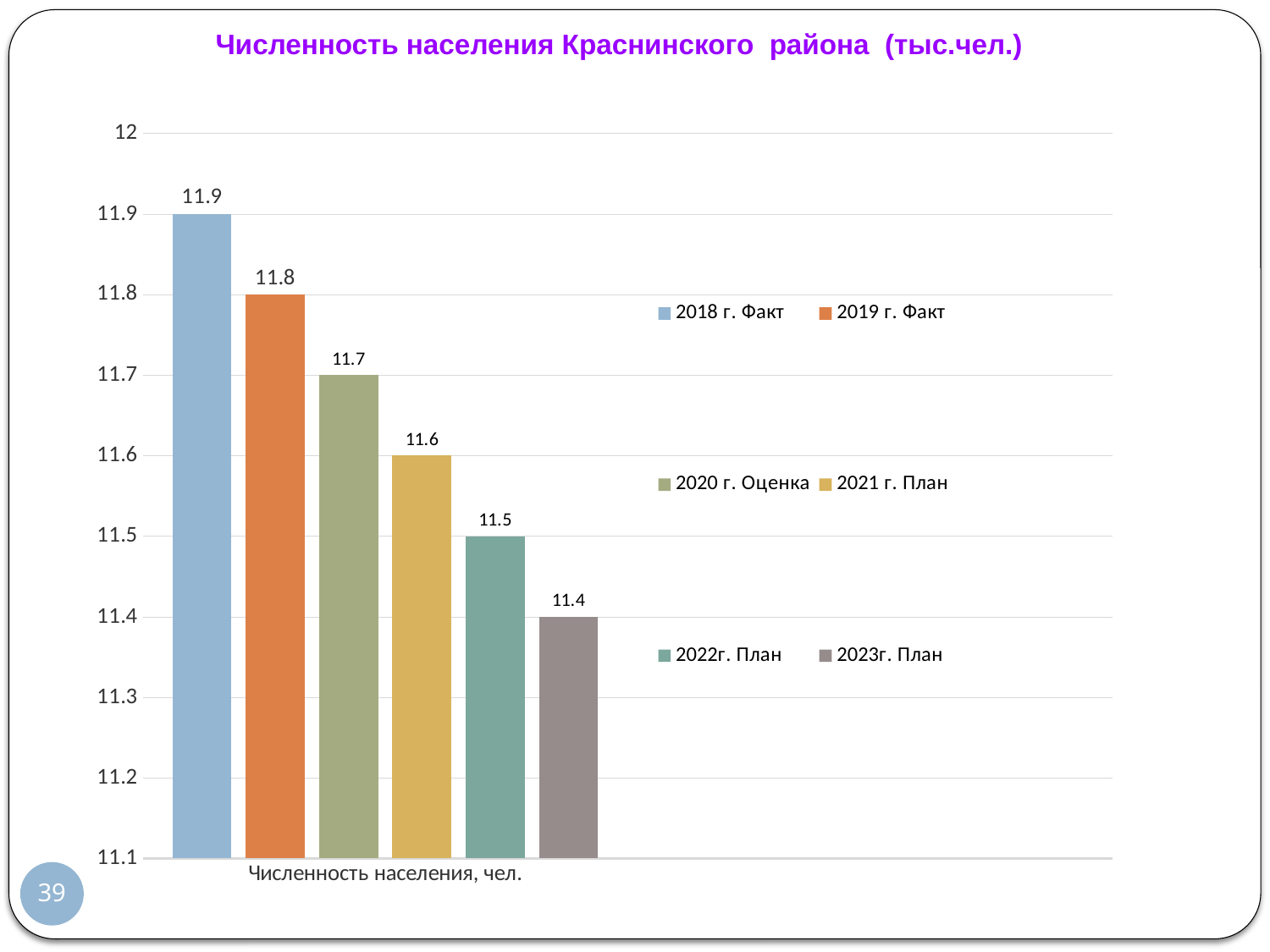
What is the value for 2021 г. План? 11.6 What is the title of the chart? Численность населения Краснинского района (тыс.чел.) What is the value for 2023г. План? 11.4 Do the values rise or fall from 2018 г. Факт to 2023г. План? fall Which series has the lowest value? 2023г. План What is the value for 2018 г. Факт? 11.9 What is the difference between the values for 2018 г. Факт and 2023г. План? 0.5 Which is larger, the value for 2019 г. Факт or the value for 2022г. План? 2019 г. Факт Which series has the highest value? 2018 г. Факт What is the difference between the values for 2020 г. Оценка and 2022г. План? 0.2 What kind of chart is shown on the slide? bar chart How many series does the legend list? 6